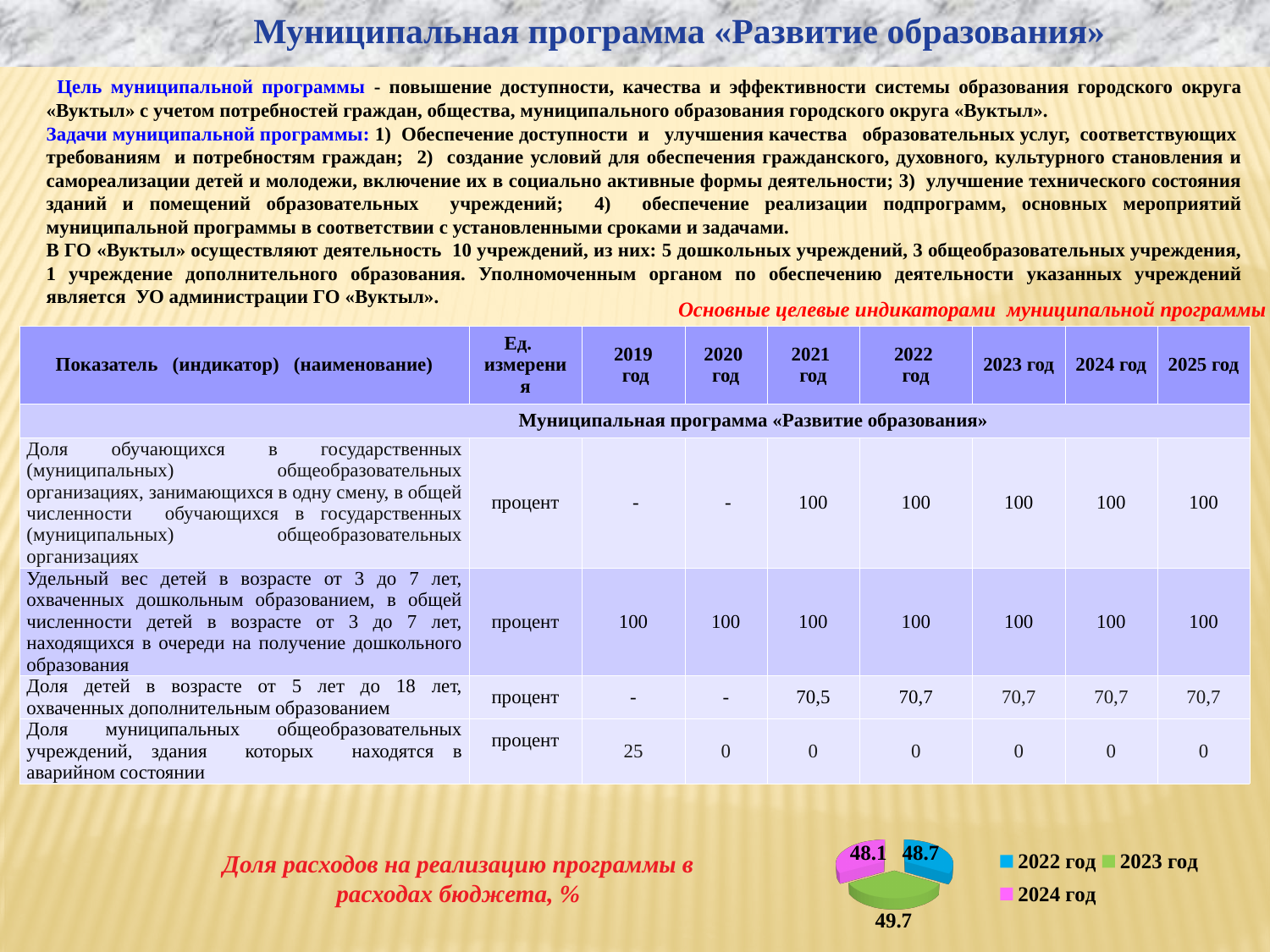
What is the smallest value shown on the pie chart? 48.1 Which years are listed in the legend of the pie chart? 2022 год, 2023 год, 2024 год What is the difference between the values 48.7 and 48.1 on the pie chart? 0.6 How many slices does the pie chart have? 3 What is the difference between the largest and smallest values on the pie chart? 1.6 What is the largest value shown on the pie chart? 49.7 Which is larger on the pie chart, the slice labelled 48.7 or the slice labelled 49.7? 49.7 What is the title of the pie chart? Доля расходов на реализацию программы в расходах бюджета, % What kind of chart is shown at the bottom of the slide? pie chart How many entries does the legend of the pie chart list? 3